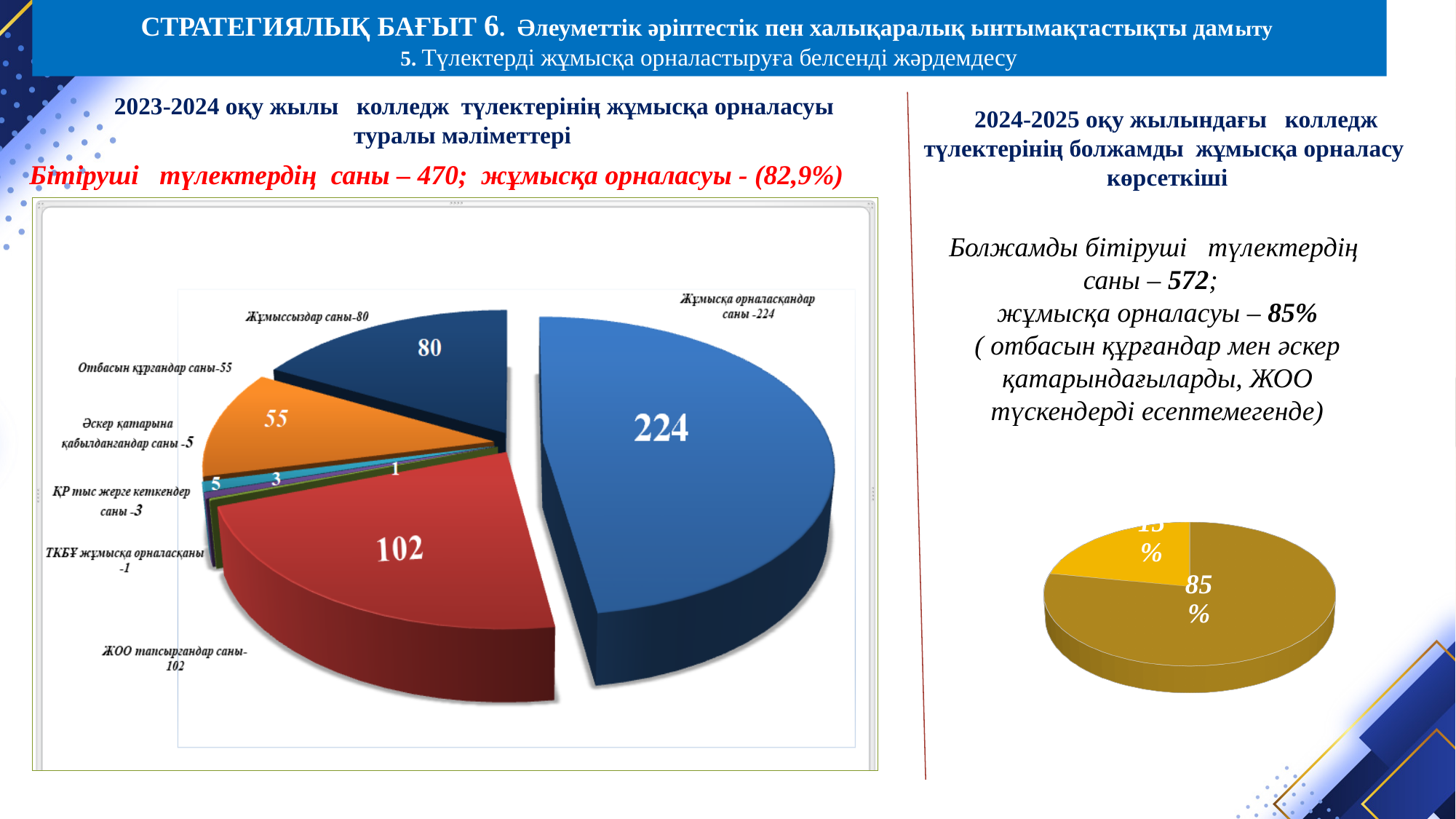
On the right pie chart, what percentage is shown on the large slice? 85% On the left pie chart, what is the value for Жұмысқа орналасқандар саны? 224 On the left pie chart, what is the value for Отбасын құрғандар саны? 55 On the left pie chart, which category has the smallest slice? ТКБҰ жұмысқа орналасқаны On the left pie chart, what colour is the slice for Жұмысқа орналасқандар саны (224)? Blue How many categories does the left pie chart show? 7 On the left pie chart, what is the value for Жұмыссыздар саны? 80 On the left pie chart, what is the difference between Жұмысқа орналасқандар саны and ЖОО тапсырғандар саны? 122 On the left pie chart, which category has the largest slice? Жұмысқа орналасқандар саны On the left pie chart, which is larger: Жұмыссыздар саны or Отбасын құрғандар саны? Жұмыссыздар саны What type of chart is shown on the left side of the slide? Pie chart On the left pie chart, what is the value for ЖОО тапсырғандар саны? 102